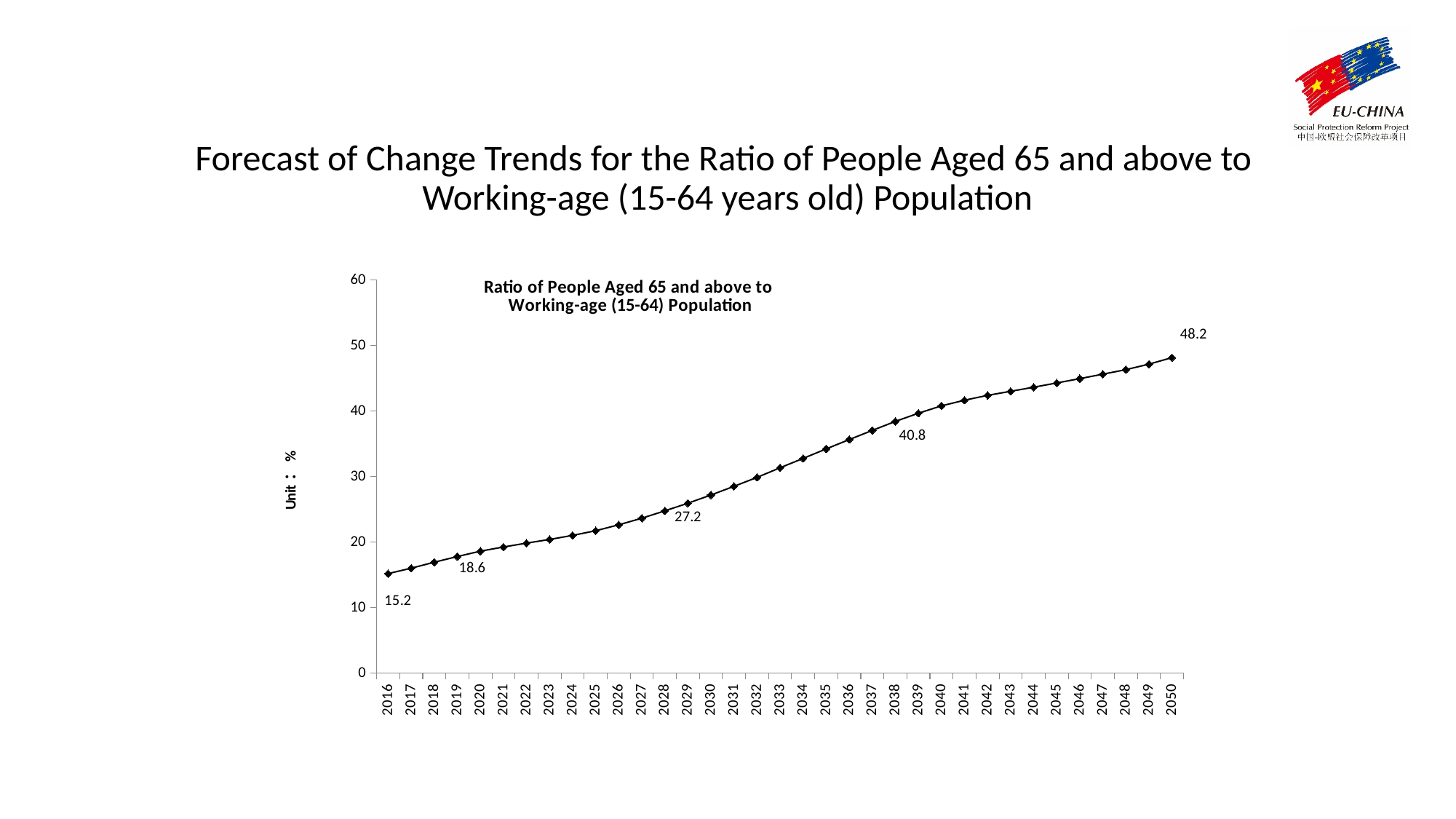
What is the value for 2050? 48.2 What type of chart is shown on the slide? line chart Which is larger, the value for 2030 or the value for 2020? 2030 Is the value for 2025 greater or less than 30? less Do the values rise or fall from 2016 to 2050? rise Which year has the lowest value? 2016 Is the value for 2045 greater or less than 40? greater What is the value for 2016? 15.2 What unit is shown on the vertical axis label? % What is the difference between the values for 2050 and 2016? 33.0 Is the value for 2035 greater or less than 30? greater Which year has the highest value? 2050